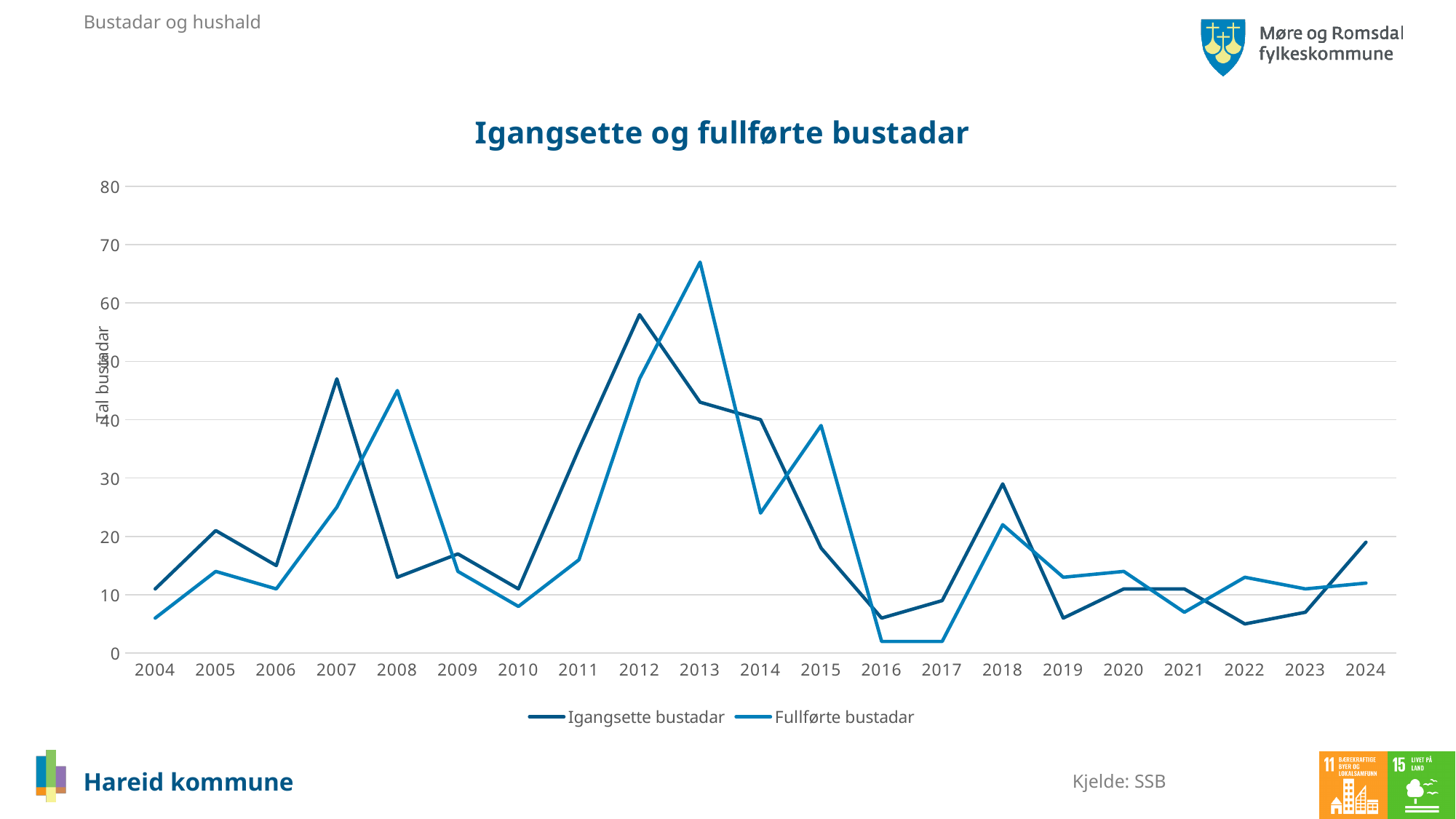
How many series does the legend list? 2 How many years are shown along the x axis? 21 In which year does the Igangsette bustadar series reach its highest value? 2012 Is the value for Igangsette bustadar in 2007 greater or less than 40? greater In 2024, which series has the larger value, Igangsette bustadar or Fullførte bustadar? Igangsette bustadar What kind of chart is shown on the slide? Line chart In 2008, which series has the larger value, Igangsette bustadar or Fullførte bustadar? Fullførte bustadar In which year does the Fullførte bustadar series reach its highest value? 2013 Is the value for Igangsette bustadar in 2012 greater or less than 50? greater Is the value for Fullførte bustadar in 2016 greater or less than 10? less Does the Igangsette bustadar series rise or fall from 2012 to 2016? Fall